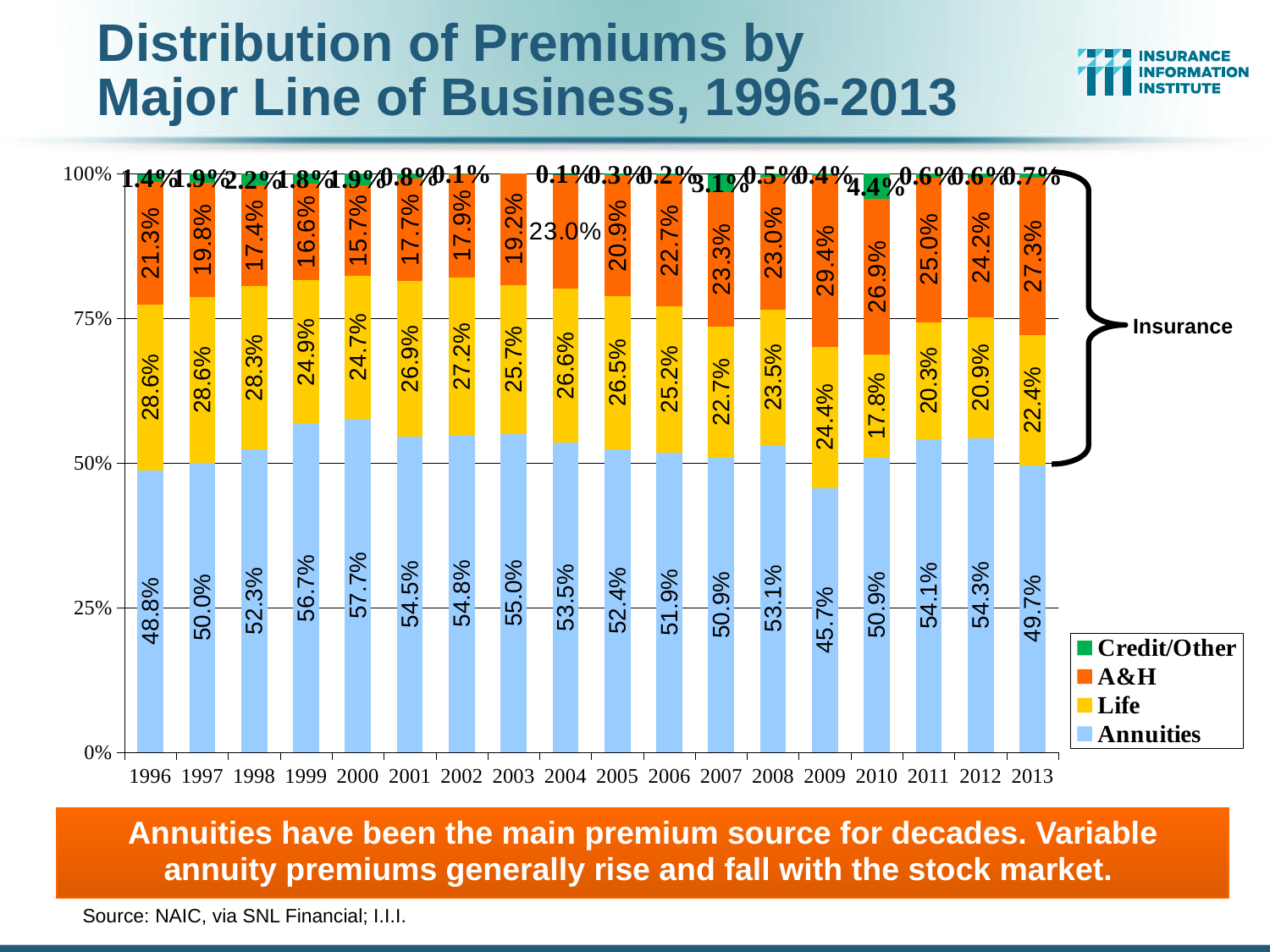
What share of premiums did Annuities account for in 2000? 57.7% What kind of chart is shown on the slide? Stacked bar chart In which year was the Annuities share of premiums highest? 2000 In which year was the Annuities share of premiums lowest? 2009 In which year was the A&H share of premiums highest? 2009 Which series is shown in orange in the legend? A&H What was the A&H share of premiums in 2009? 29.4% Which year had a larger Life share of premiums, 1996 or 2013? 1996 What is the difference between the Annuities share in 2000 and in 2009? 12.0 percentage points How many years are shown along the x axis? 18 How many series does the legend list? 4 What was the Life share of premiums in 2010? 17.8%